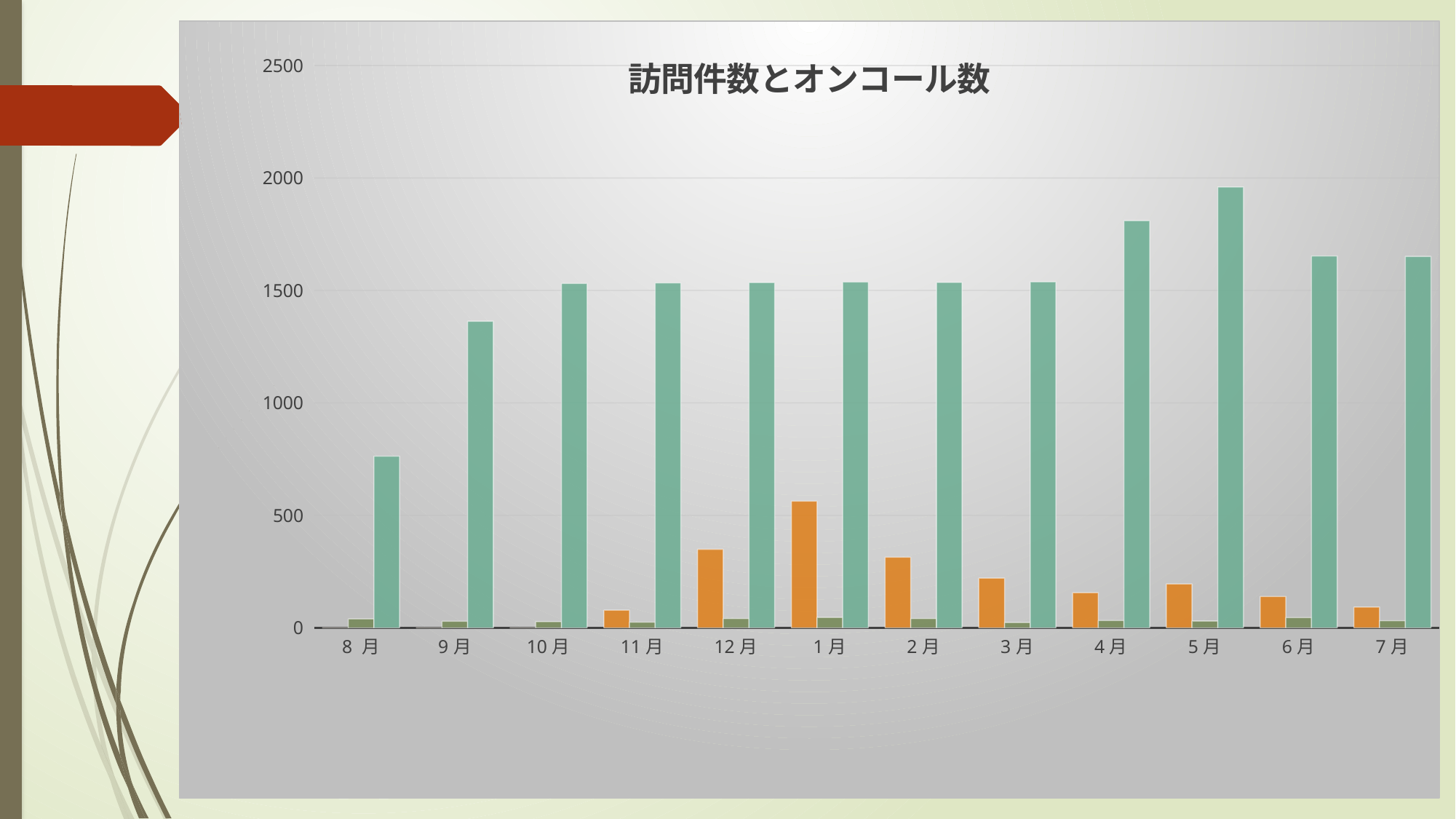
What kind of chart is shown on the slide? bar chart How many differently coloured bar series are plotted in the chart? 3 Is the orange bar for 12月 greater or less than 500? less Is the teal bar for 5月 greater or less than 1500? greater Is the teal bar for 8月 greater or less than 1000? less What is the title of the chart? 訪問件数とオンコール数 Which month has the larger orange bar, 1月 or 3月? 1月 How many months are shown along the x axis of the chart? 12 Which month has the shortest teal bar? 8月 Which month has the tallest orange bar? 1月 Which month has the larger teal bar, 4月 or 5月? 5月 Which month has the tallest teal bar? 5月